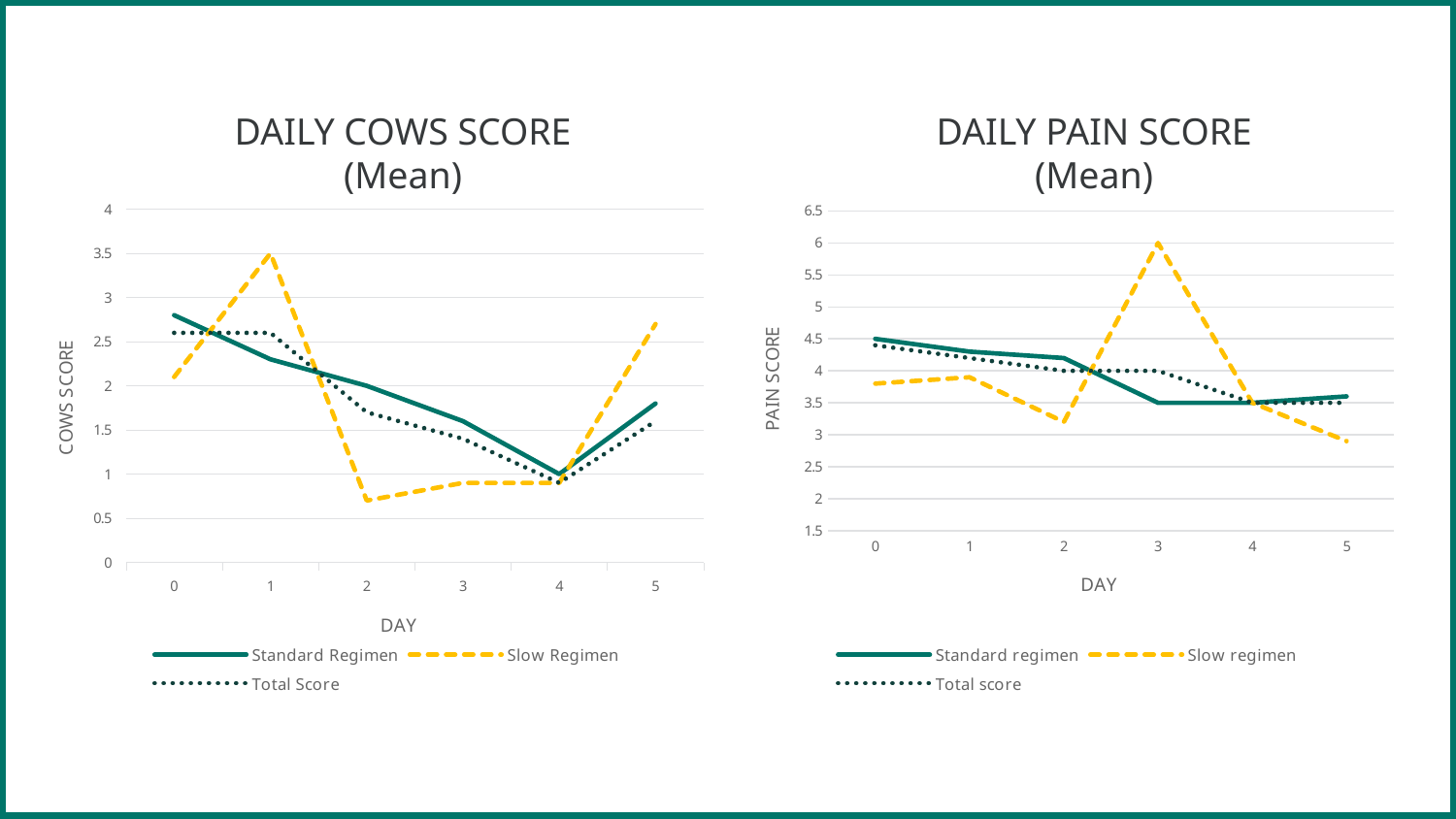
How many series does the legend of the DAILY PAIN SCORE (Mean) chart list? 3 In the DAILY PAIN SCORE (Mean) chart, on which day does the Slow regimen line reach its highest value? 3 In the DAILY PAIN SCORE (Mean) chart, which is larger on day 3: the Standard regimen value or the Slow regimen value? Slow regimen In the DAILY COWS SCORE (Mean) chart, is the Slow Regimen value on day 2 greater or less than 1? less In the DAILY COWS SCORE (Mean) chart, on which day does the Slow Regimen line reach its highest value? 1 How many days are plotted along the x axis of the DAILY COWS SCORE (Mean) chart? 6 What kind of chart is the DAILY COWS SCORE (Mean) chart? line chart In the DAILY COWS SCORE (Mean) chart, which is larger on day 0: the Standard Regimen value or the Slow Regimen value? Standard Regimen In the DAILY COWS SCORE (Mean) chart, what is the Slow Regimen value on day 1? 3.5 In the DAILY COWS SCORE (Mean) chart, does the Standard Regimen line rise or fall from day 0 to day 4? fall In the DAILY PAIN SCORE (Mean) chart, what is the Slow regimen value on day 3? 6